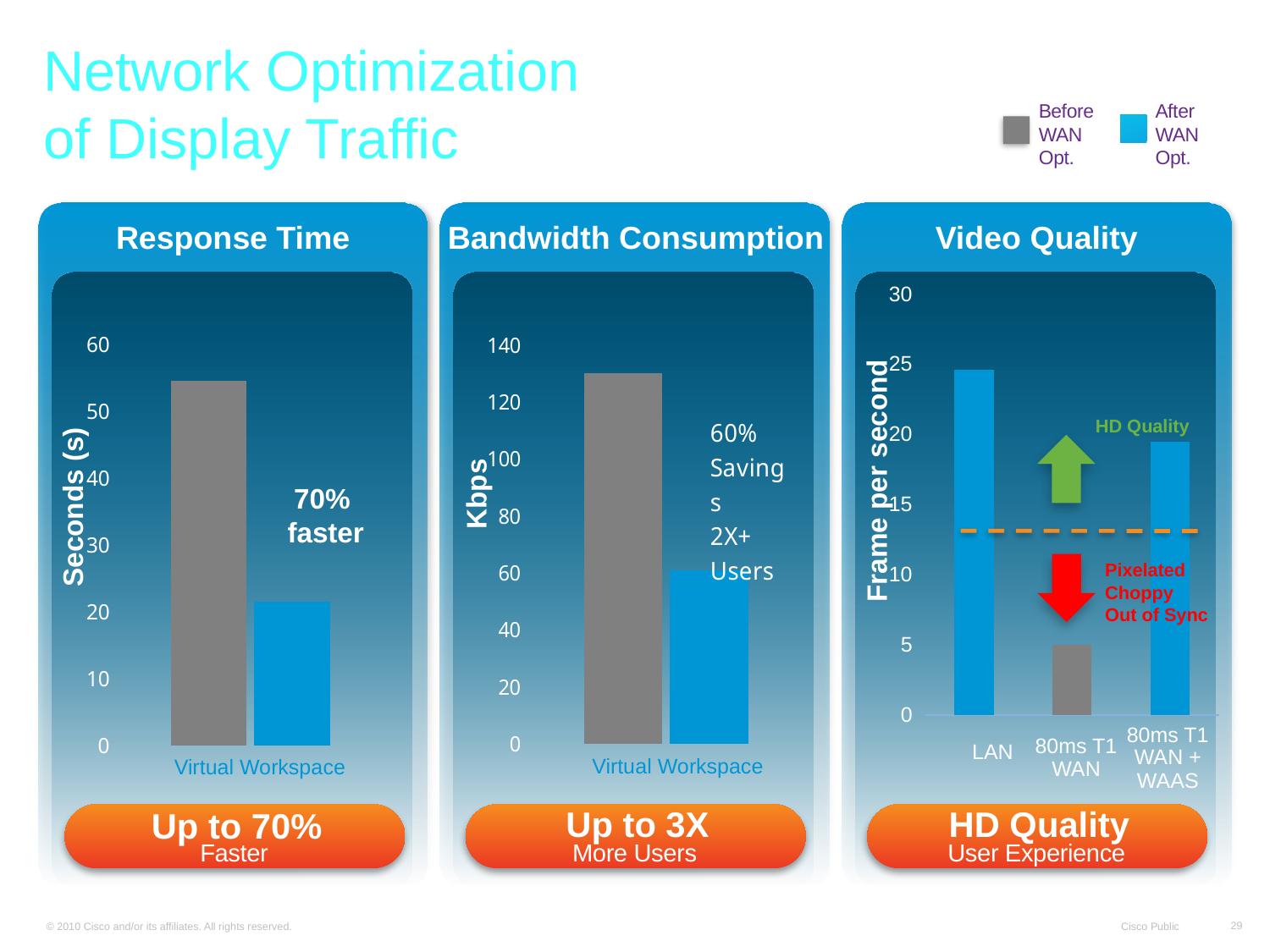
In the Response Time chart, which series has the larger value for Virtual Workspace, Before WAN Opt. or After WAN Opt.? Before WAN Opt. In the Bandwidth Consumption chart, is the value for Before WAN Opt. greater or less than 120? greater How many series does the legend at the top of the slide list? 2 What is the y-axis label of the Bandwidth Consumption chart? Kbps What kind of chart is the Response Time chart? bar chart In the Response Time chart, is the value for Before WAN Opt. greater or less than 50? greater In the Response Time chart, is the value for After WAN Opt. greater or less than 30? less How many categories are shown on the x axis of the Video Quality chart? 3 In the Video Quality chart, which category has the highest value? LAN In the Video Quality chart, which category has the lowest value? 80ms T1 WAN